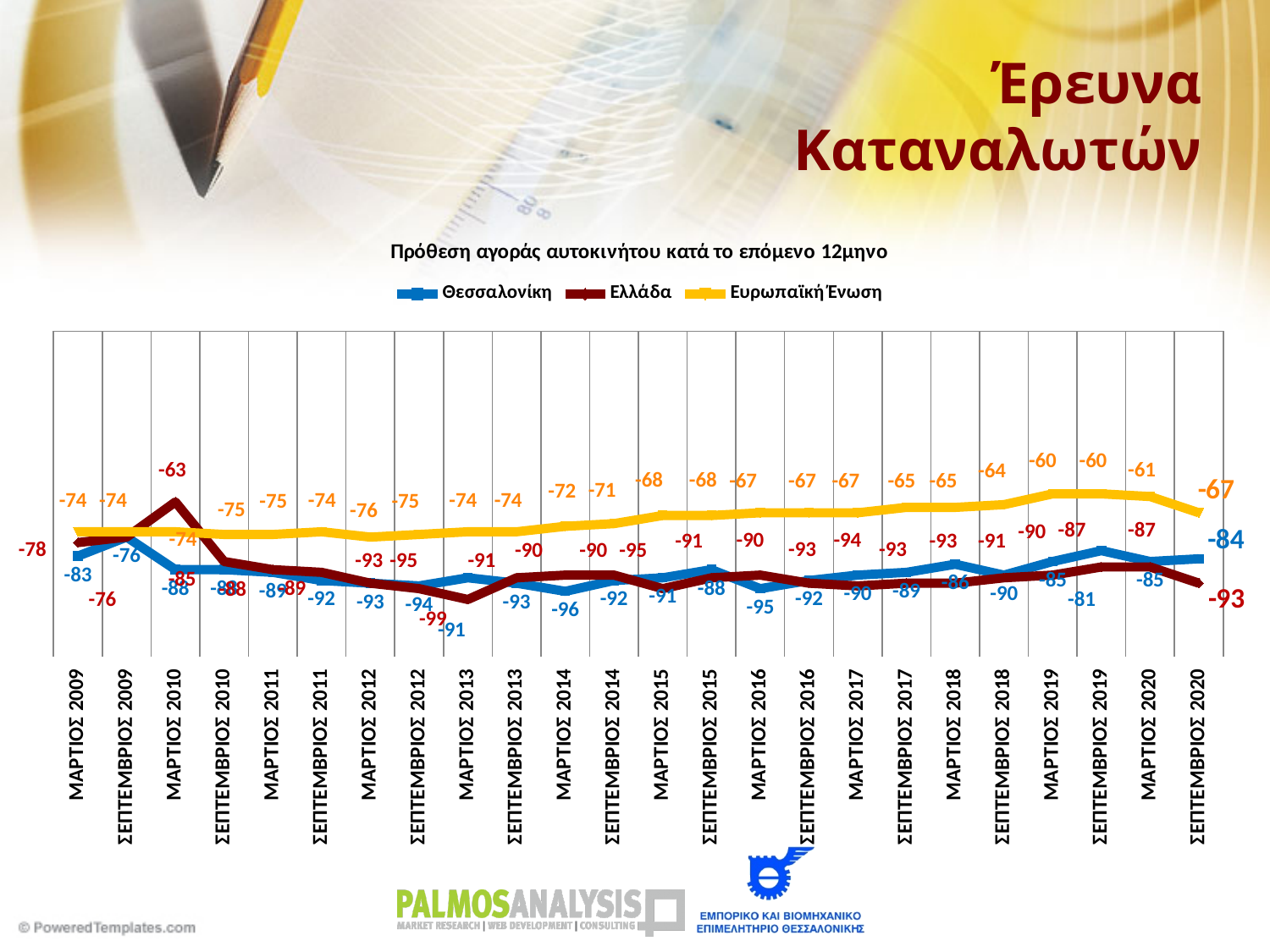
Does the Ευρωπαϊκή Ένωση line rise or fall from ΜΑΡΤΙΟΣ 2015 to ΣΕΠΤΕΜΒΡΙΟΣ 2019? rise What is the value for Θεσσαλονίκη in ΜΑΡΤΙΟΣ 2009? -83 What is the difference between the Θεσσαλονίκη and Ελλάδα values in ΣΕΠΤΕΜΒΡΙΟΣ 2020? 9 What is the value for Ευρωπαϊκή Ένωση in ΣΕΠΤΕΜΒΡΙΟΣ 2020? -67 How many time points are plotted along the x axis? 24 What is the lowest value plotted for Ευρωπαϊκή Ένωση? -76 How many series does the legend list? 3 What kind of chart is shown on the slide? line chart In ΣΕΠΤΕΜΒΡΙΟΣ 2020, which series has the higher value, Ευρωπαϊκή Ένωση or Ελλάδα? Ευρωπαϊκή Ένωση What is the title of the chart? Πρόθεση αγοράς αυτοκινήτου κατά το επόμενο 12μηνο What is the value for Ελλάδα in ΣΕΠΤΕΜΒΡΙΟΣ 2020? -93 What is the value for Θεσσαλονίκη in ΣΕΠΤΕΜΒΡΙΟΣ 2020? -84